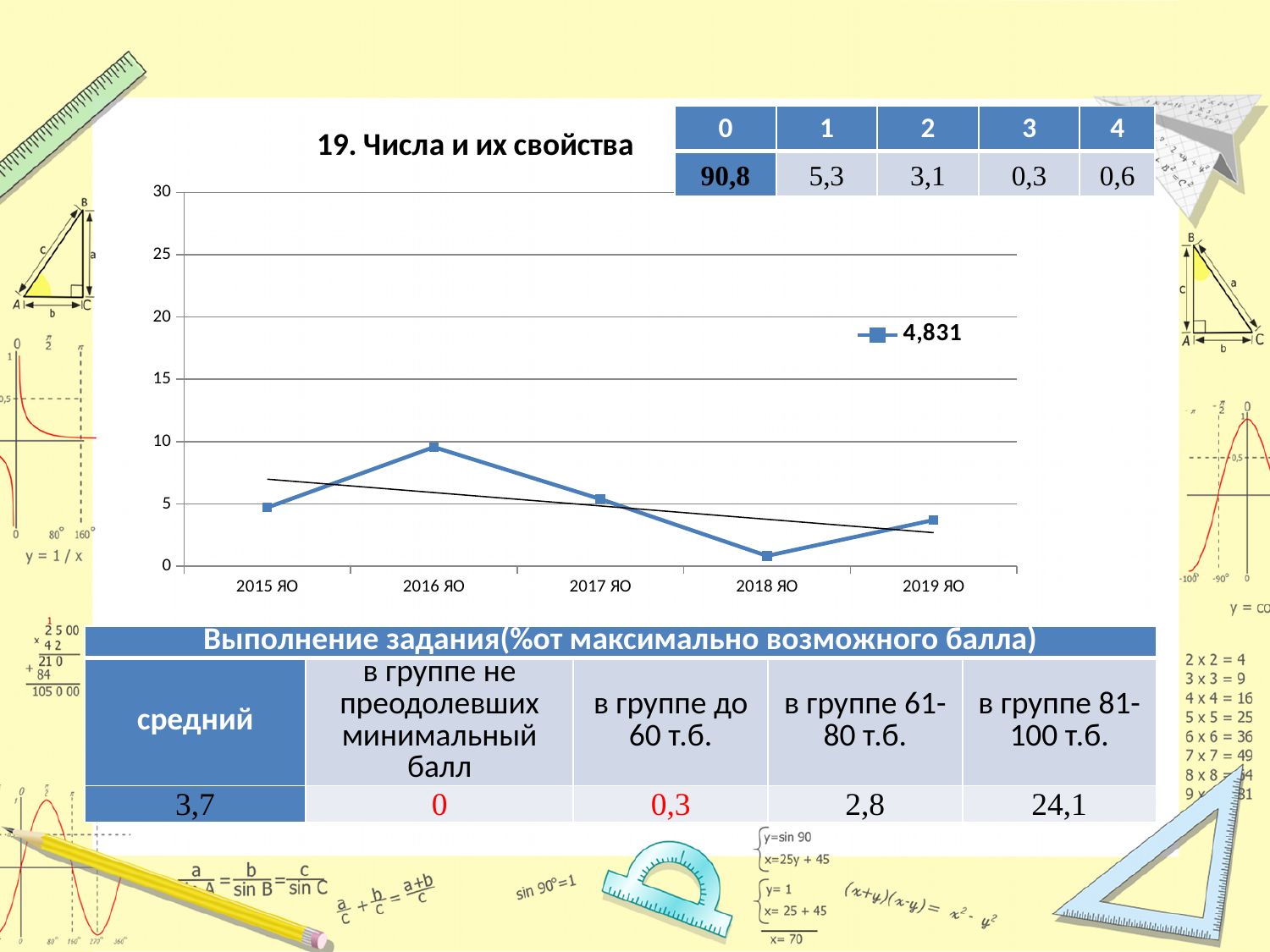
Which category has the highest value on the chart? 2016 ЯО How many categories are shown on the x axis of the chart? 5 Is the value for 2016 ЯО greater or less than 5? greater Is the value for 2018 ЯО greater or less than 5? less What is the legend entry shown on the chart? 4,831 Which is larger, the value for 2016 ЯО or the value for 2018 ЯО? 2016 ЯО Does the black trend line on the chart rise or fall from 2015 ЯО to 2019 ЯО? fall What is the title of the chart? 19. Числа и их свойства What kind of chart is shown on the slide? line chart Which category has the lowest value on the chart? 2018 ЯО How many series does the chart legend list? 1 Is the value for 2015 ЯО greater or less than 10? less